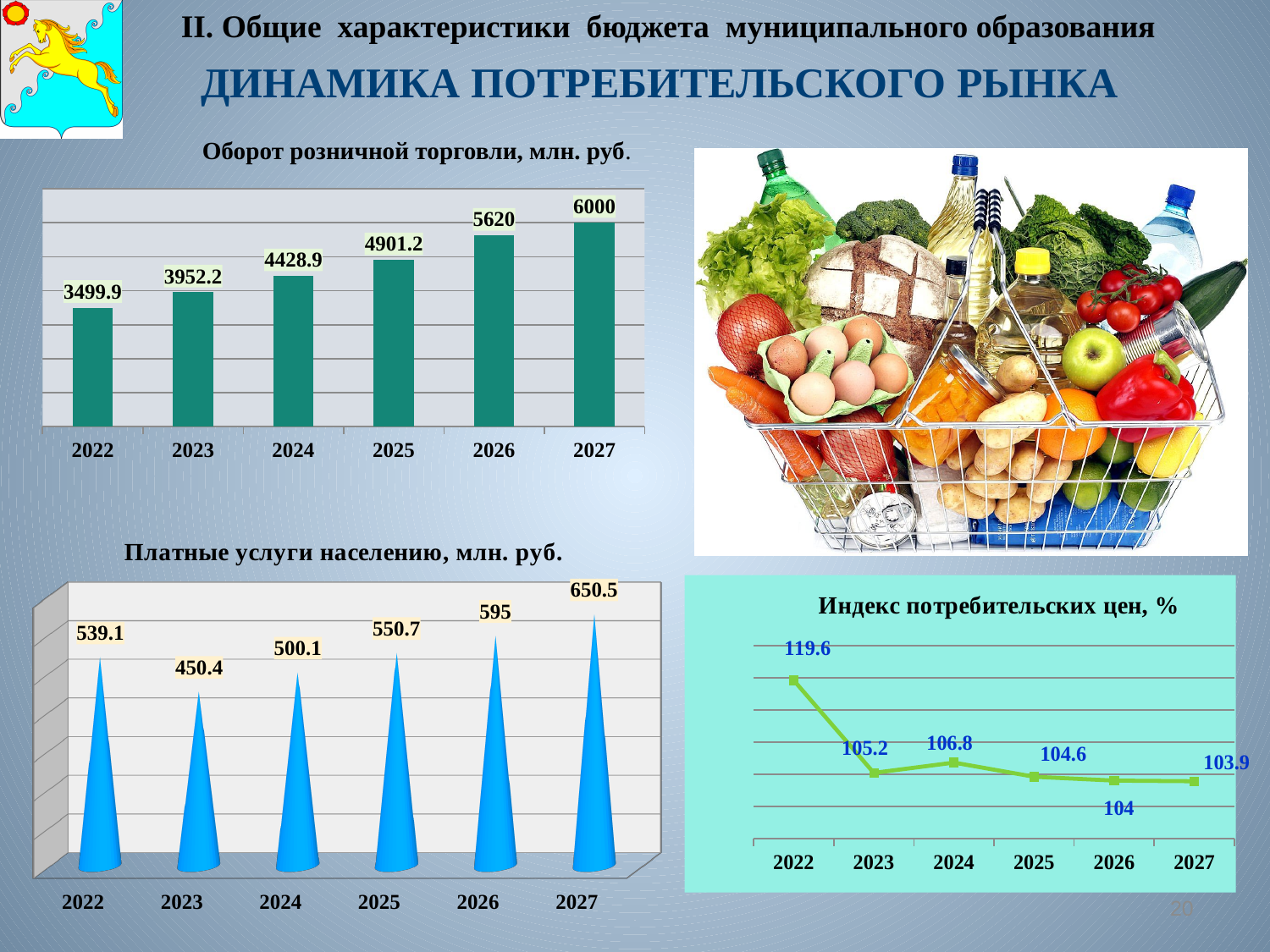
In the chart 'Индекс потребительских цен, %', which year has the lowest value? 2027 In the chart 'Платные услуги населению, млн. руб.', how many years are shown? 6 In the chart 'Оборот розничной торговли, млн. руб.', what is the value for 2024? 4428.9 In the chart 'Оборот розничной торговли, млн. руб.', what is the difference between the values for 2027 and 2026? 380 What kind of chart is 'Оборот розничной торговли, млн. руб.'? bar chart In the chart 'Платные услуги населению, млн. руб.', which is larger, the value for 2022 or the value for 2024? 2022 In the chart 'Индекс потребительских цен, %', what is the difference between the values for 2022 and 2023? 14.4 In the chart 'Оборот розничной торговли, млн. руб.', do the values rise or fall from 2022 to 2027? rise In the chart 'Платные услуги населению, млн. руб.', what is the value for 2023? 450.4 In the chart 'Платные услуги населению, млн. руб.', which year has the lowest value? 2023 In the chart 'Индекс потребительских цен, %', what is the value for 2022? 119.6 In the chart 'Оборот розничной торговли, млн. руб.', which year has the highest value? 2027